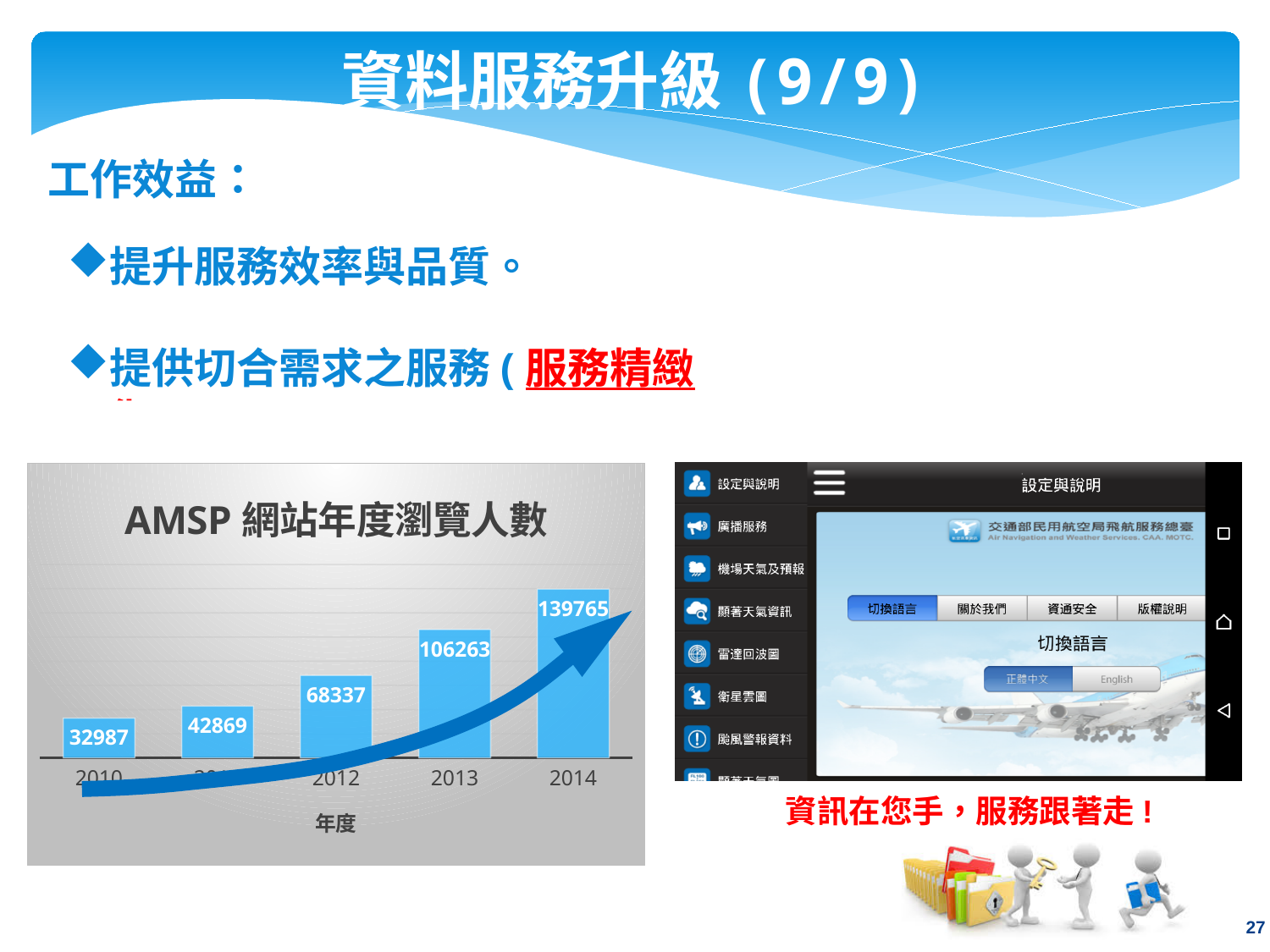
In the AMSP 網站年度瀏覽人數 chart, do the values rise or fall from 2010 to 2014? rise In the AMSP 網站年度瀏覽人數 chart, what is the value for 2013? 106263 In the AMSP 網站年度瀏覽人數 chart, what is the value for 2010? 32987 In the AMSP 網站年度瀏覽人數 chart, what is the difference between the values for 2013 and 2012? 37926 In the AMSP 網站年度瀏覽人數 chart, what is the difference between the values for 2014 and 2013? 33502 In the AMSP 網站年度瀏覽人數 chart, which year has the lowest value? 2010 In the AMSP 網站年度瀏覽人數 chart, what is the value for 2012? 68337 In the AMSP 網站年度瀏覽人數 chart, what is the value for 2014? 139765 How many bars are shown in the AMSP 網站年度瀏覽人數 chart? 5 What kind of chart is the AMSP 網站年度瀏覽人數 chart? bar chart In the AMSP 網站年度瀏覽人數 chart, which is larger, the value for 2012 or the value for 2013? 2013 In the AMSP 網站年度瀏覽人數 chart, which year has the highest value? 2014